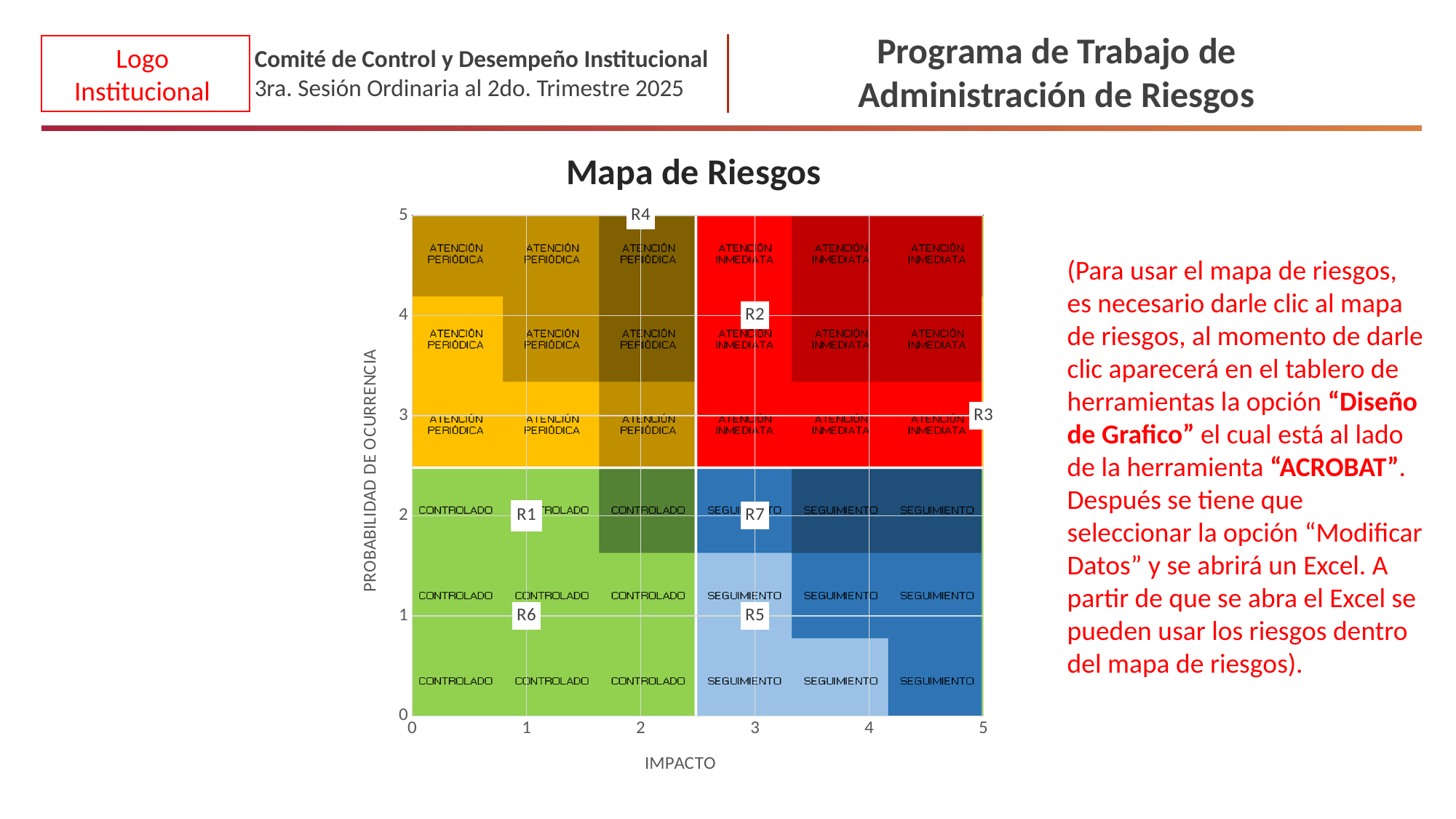
Is the impact value for R3 greater or less than 4? greater What is the impact value for R3? 5 Which risk point has the highest probability of occurrence (PROBABILIDAD DE OCURRENCIA)? R4 How many risk points (R labels) are plotted on the chart? 7 What is the impact value for R2? 3 What is the label of the horizontal axis of the chart? IMPACTO What is the title of the chart? Mapa de Riesgos What kind of chart is the "Mapa de Riesgos"? scatter chart Which has a higher probability of occurrence, R4 or R6? R4 What is the difference between the probability of occurrence of R4 and that of R6? 4 Which risk point has the highest impact (IMPACTO)? R3 What is the probability of occurrence value for R4? 5